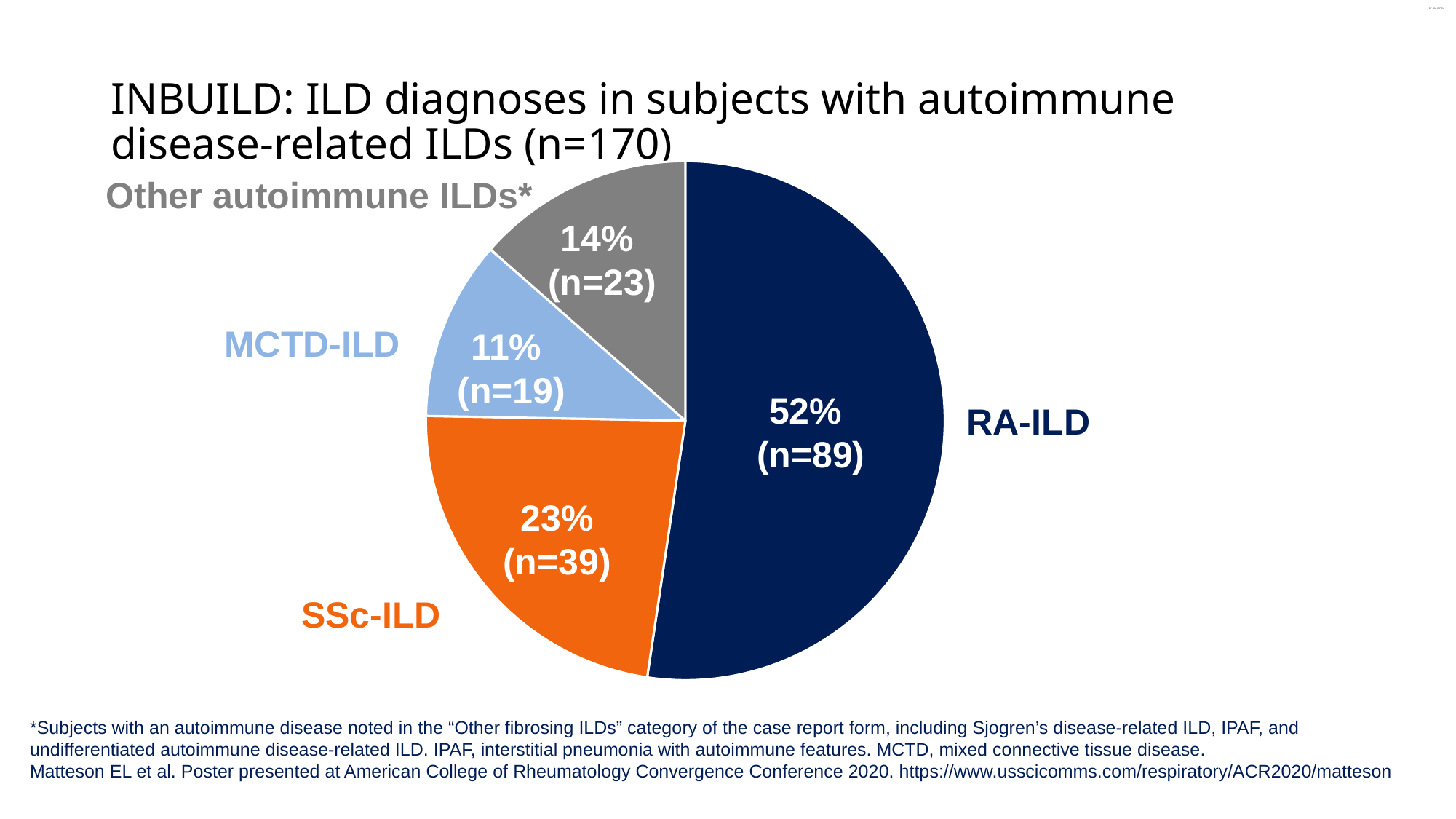
How many subjects had SSc-ILD? n=39 What is the difference in percentage points between Other autoimmune ILDs* and MCTD-ILD? 3% What kind of chart is shown on the slide? Pie chart How many categories does the pie chart show? 4 What colour is the SSc-ILD slice? Orange Which has more subjects, SSc-ILD or Other autoimmune ILDs*? SSc-ILD What is the difference in number of subjects between RA-ILD and SSc-ILD? 50 Which ILD diagnosis accounts for the largest share of subjects? RA-ILD Which ILD diagnosis accounts for the smallest share of subjects? MCTD-ILD What percentage of subjects had RA-ILD? 52% What percentage of subjects had MCTD-ILD? 11% How many subjects are in the Other autoimmune ILDs* category? n=23